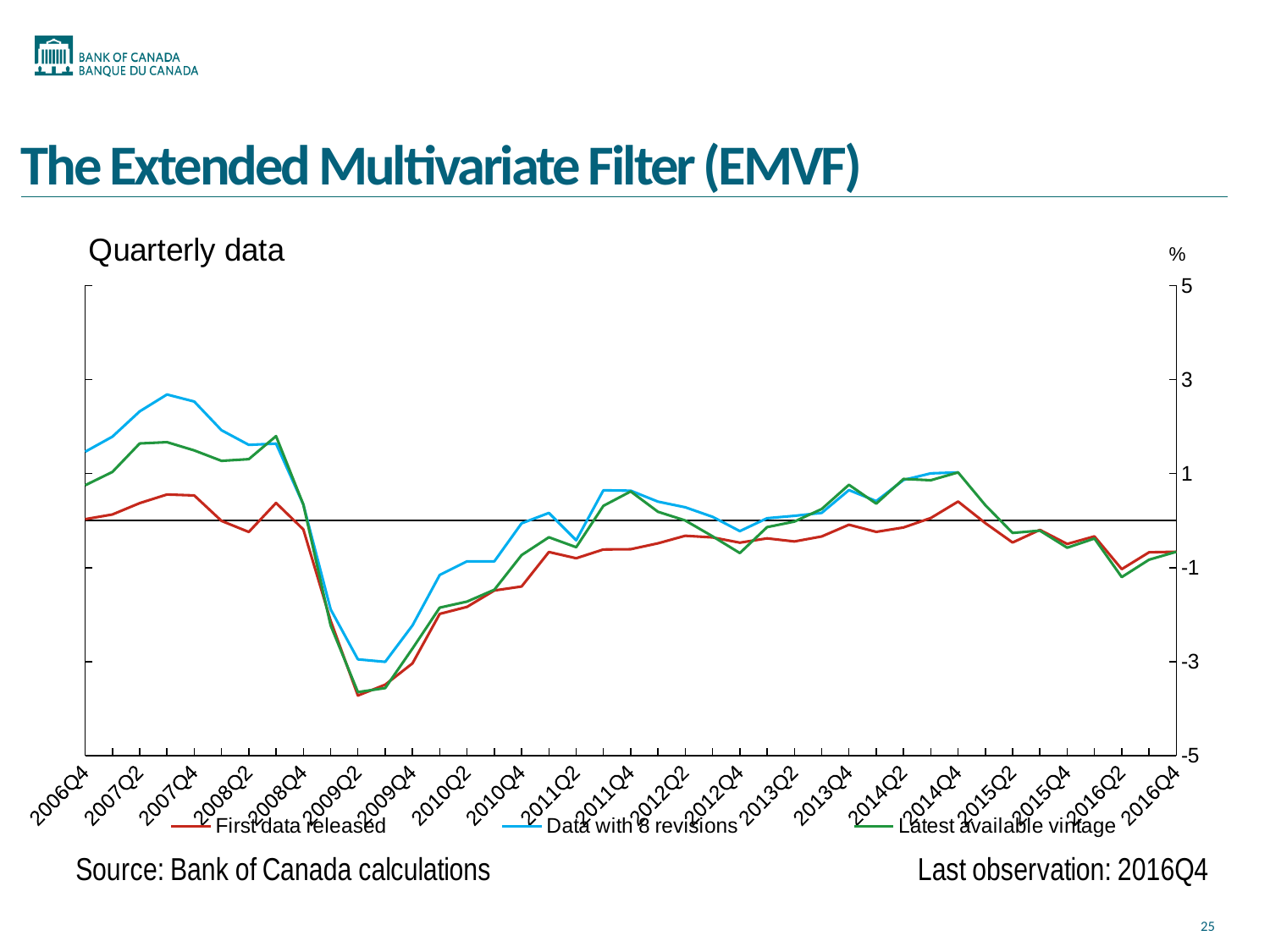
Which series reaches the highest value anywhere on the chart? Data with 8 revisions Is the value for First data released at 2014Q4 greater or less than 0? greater How many series does the legend list? 3 Is the value for Data with 8 revisions at 2007Q4 greater or less than 1? greater Is the value for First data released at 2009Q2 greater or less than -3? less What are the three series named in the legend? First data released, Data with 8 revisions, Latest available vintage Does the First data released series rise or fall between 2008Q4 and 2009Q2? fall At 2007Q4, which series has the higher value: First data released or Data with 8 revisions? Data with 8 revisions At 2009Q2, which series has the higher value: Data with 8 revisions or First data released? Data with 8 revisions What unit is shown at the top of the y axis? % What kind of chart is shown on the slide? line chart